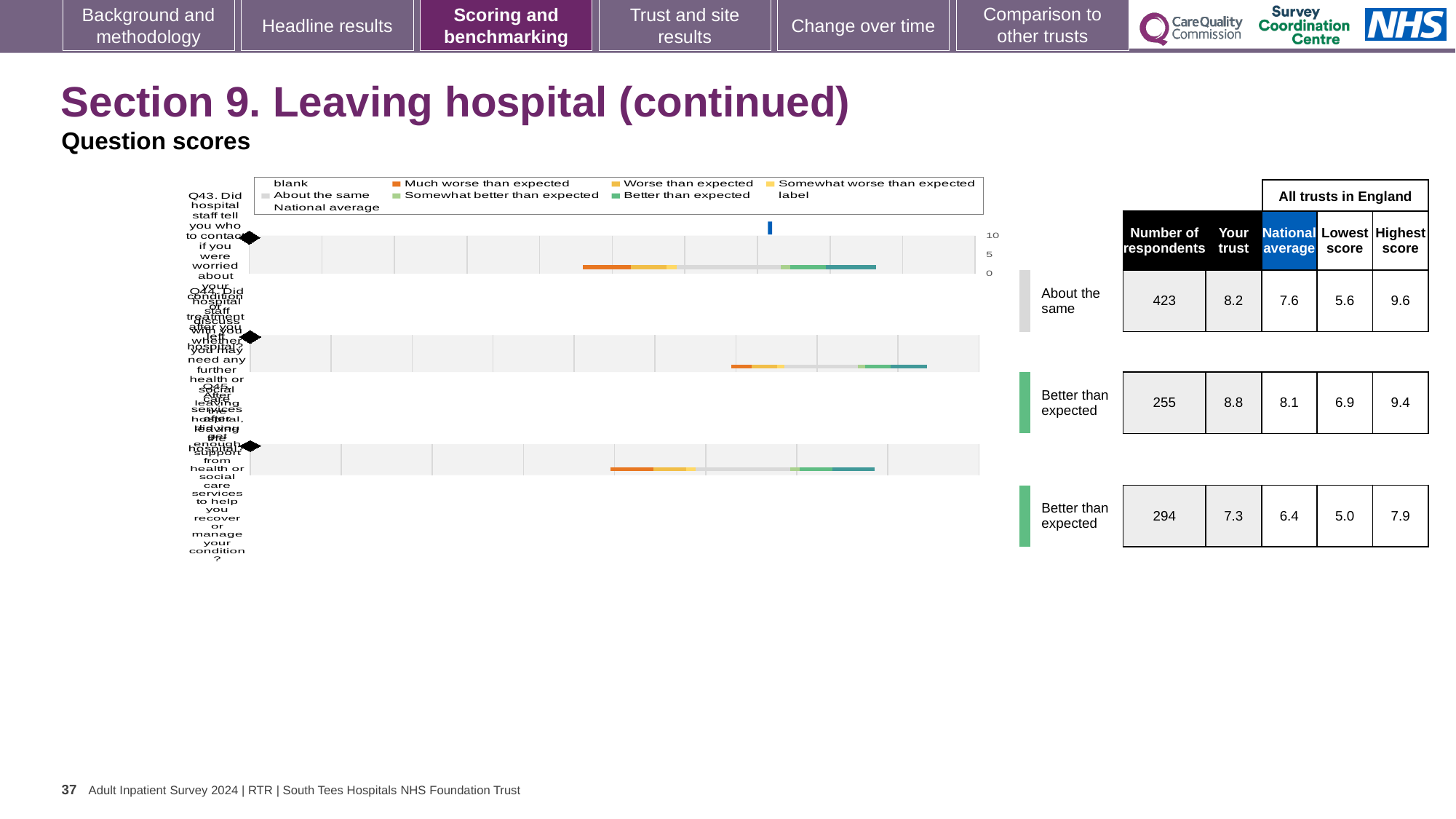
For Q43 (the first question row), which is larger: the 'Your trust' score or the national average? Your trust Which question row has the lowest number of respondents? The second row (255) For Q43 (the first question row), what is the difference between the highest score and the lowest score across all trusts in England? 4.0 What is the lowest score across all trusts in England for the third question row? 5.0 Which question row has the highest 'Your trust' score? The second row (8.8) What benchmark category label is shown for Q43 (the first question row)? About the same How many question rows are plotted in the chart? 3 What colour does the legend use for 'Much worse than expected'? Orange What is the national average score for Q43 (the first question row)? 7.6 What kind of chart is shown on the slide? Bar chart What is the 'Your trust' score for Q43 (the first question row)? 8.2 What is the number of respondents for Q43 (the first question row)? 423